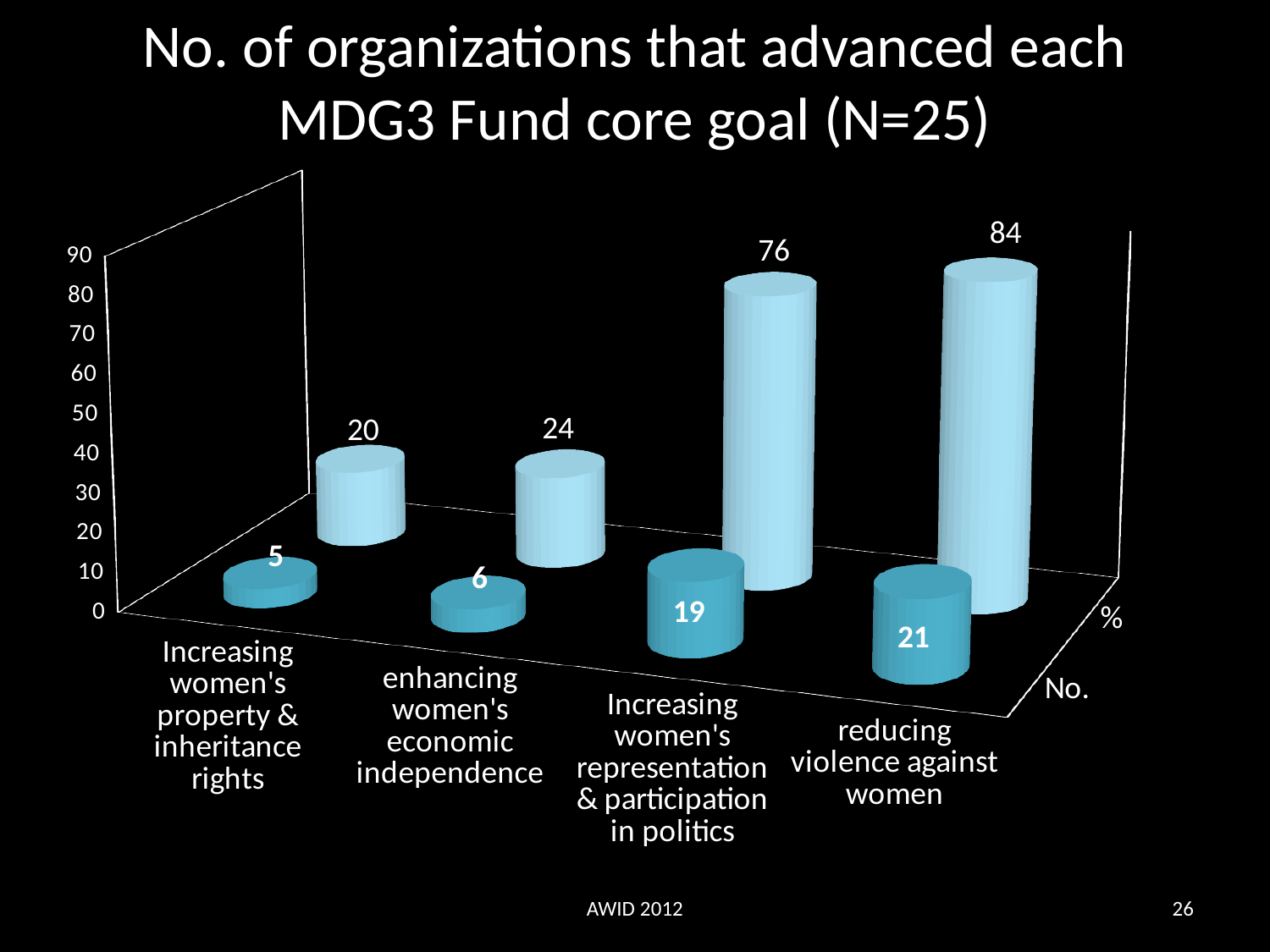
What is the '%' value for 'Increasing women's representation & participation in politics'? 76 Is the '%' value for 'reducing violence against women' greater or less than 80? greater What is the 'No.' value for 'reducing violence against women'? 21 Which category has the highest '%' value? reducing violence against women What is the '%' value for 'enhancing women's economic independence'? 24 Which category has the lowest 'No.' value? Increasing women's property & inheritance rights What kind of chart is shown on the slide? bar chart Which is larger: the 'No.' value for 'enhancing women's economic independence' or for 'Increasing women's representation & participation in politics'? Increasing women's representation & participation in politics How many categories are shown on the x axis? 4 What is the 'No.' value for 'Increasing women's property & inheritance rights'? 5 How many data series are plotted in the chart? 2 What is the difference between the '%' values for 'reducing violence against women' and 'Increasing women's representation & participation in politics'? 8